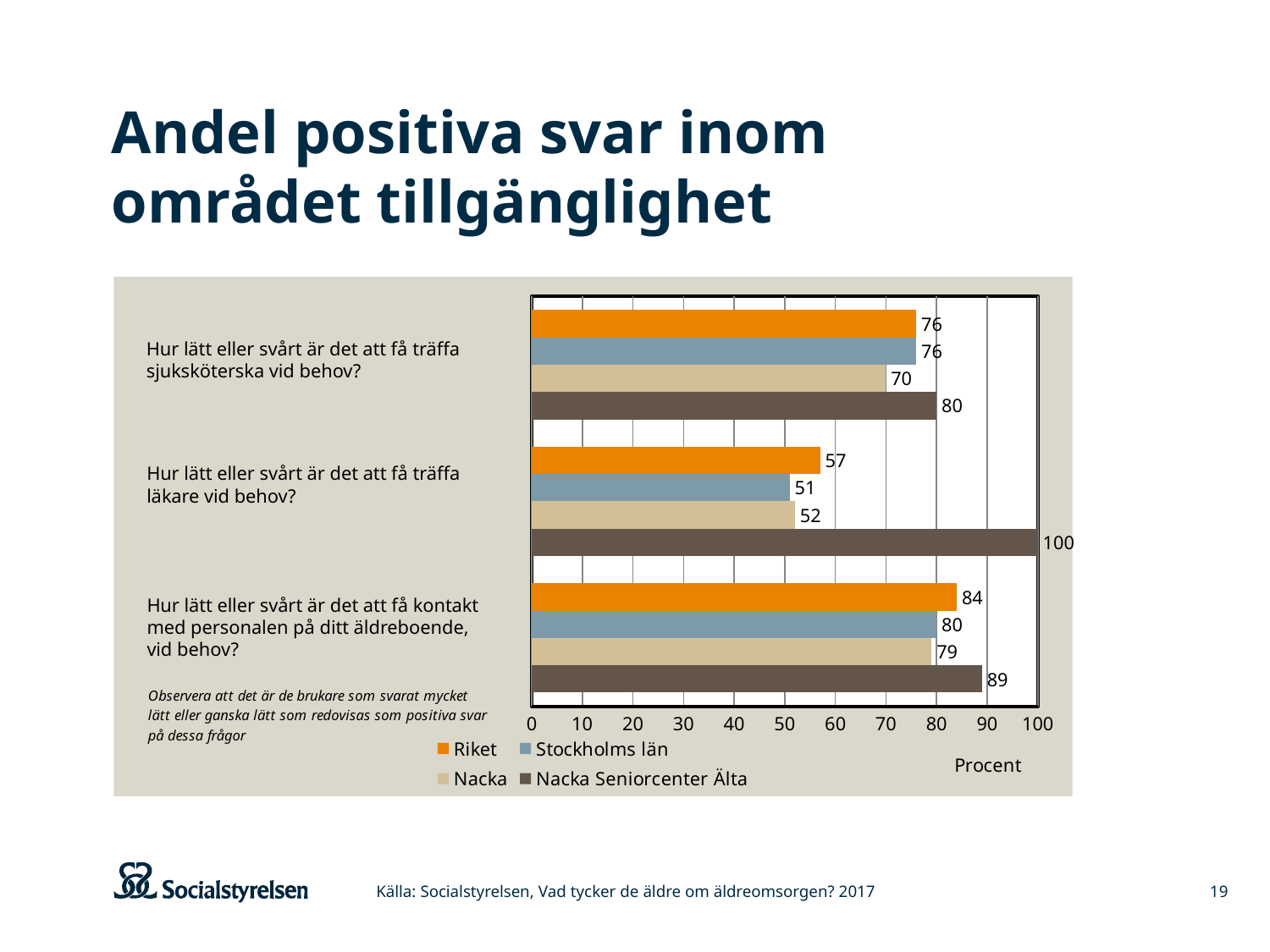
What is the value for Stockholms län on the question "Hur lätt eller svårt är det att få träffa läkare vid behov?"? 51 What is the difference between Riket and Nacka on the question "Hur lätt eller svårt är det att få träffa sjuksköterska vid behov?"? 6 What kind of chart is shown on the slide? Bar chart Which series has the lowest value on the question "Hur lätt eller svårt är det att få träffa läkare vid behov?"? Stockholms län How many series does the legend list? 4 What is the difference between Nacka Seniorcenter Älta and Riket on the question "Hur lätt eller svårt är det att få träffa läkare vid behov?"? 43 On the question "Hur lätt eller svårt är det att få kontakt med personalen på ditt äldreboende, vid behov?", which is larger: Stockholms län or Nacka? Stockholms län What is the value for Nacka on the question "Hur lätt eller svårt är det att få träffa sjuksköterska vid behov?"? 70 How many question categories are shown on the chart? 3 What is the value for Nacka Seniorcenter Älta on the question "Hur lätt eller svårt är det att få träffa läkare vid behov?"? 100 What is the value for Riket on the question "Hur lätt eller svårt är det att få kontakt med personalen på ditt äldreboende, vid behov?"? 84 Which series has the highest value on the question "Hur lätt eller svårt är det att få kontakt med personalen på ditt äldreboende, vid behov?"? Nacka Seniorcenter Älta